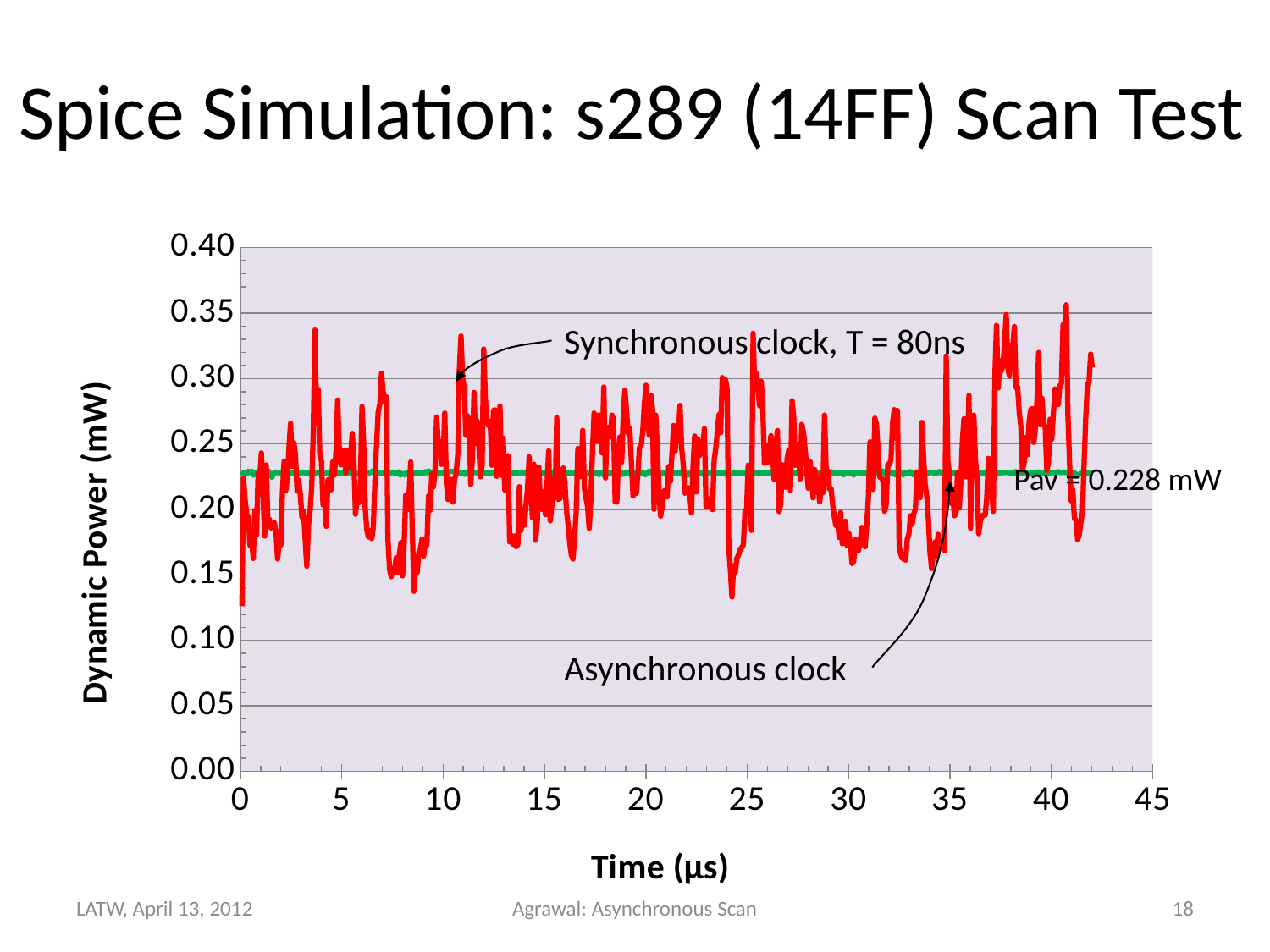
What kind of chart is shown on the slide? line chart What is the average power (Pav) of the asynchronous clock as printed on the chart? 0.228 mW How many clock series are plotted on the chart? 2 What is the label of the y axis? Dynamic Power (mW) What clock period T is given for the synchronous clock on the chart? 80ns What is the label of the x axis? Time (µs) Is the asynchronous clock power level greater or less than 0.25 mW? less Is the asynchronous clock power level greater or less than 0.20 mW? greater Does the asynchronous clock power rise, fall, or stay roughly flat over time? stays roughly flat Is the highest peak of the synchronous clock power greater or less than 0.30 mW? greater Which series shows the larger fluctuation in dynamic power over time, the synchronous clock or the asynchronous clock? Synchronous clock